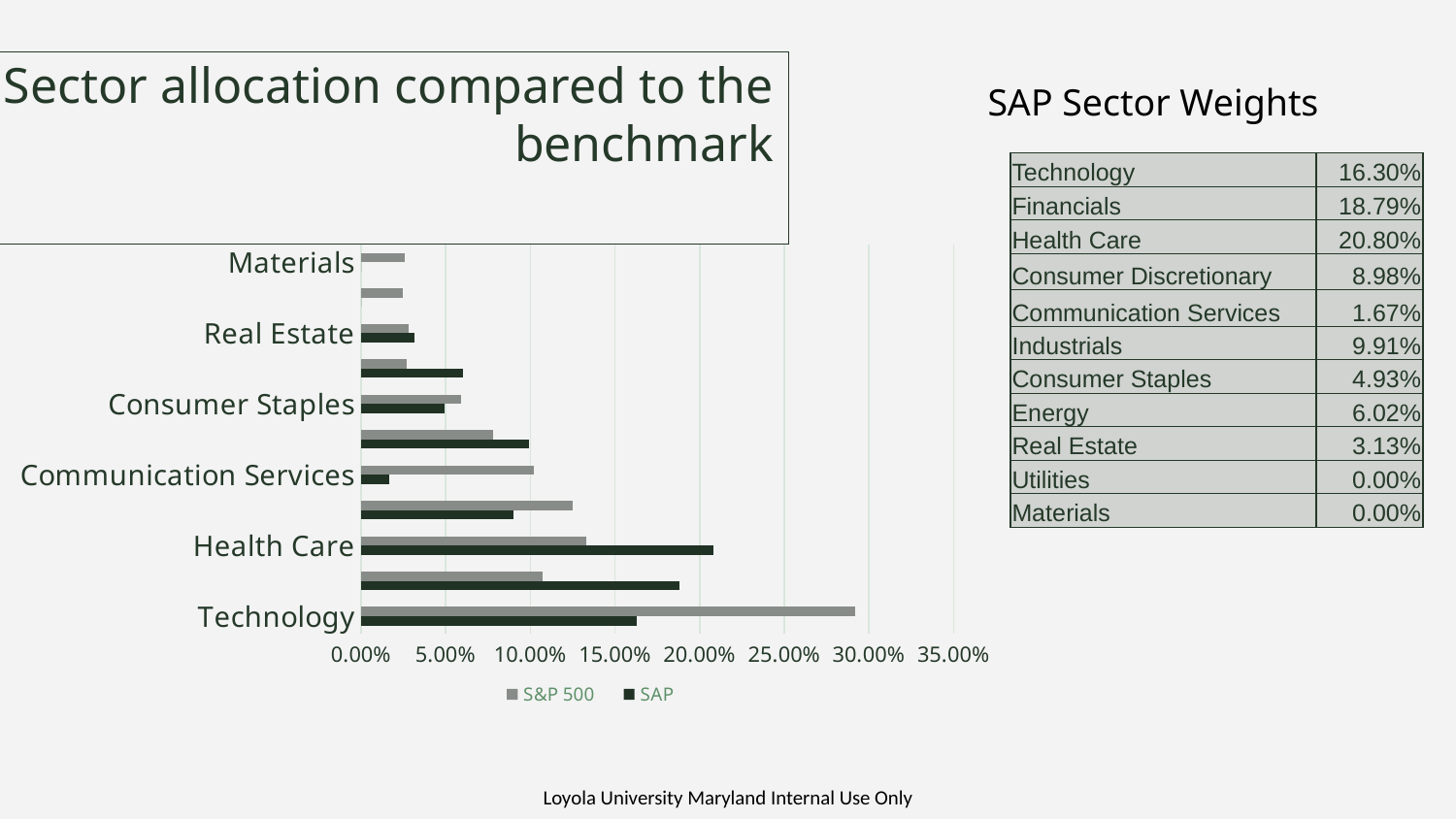
What is the highest value shown on the chart's horizontal axis? 35.00% What kind of chart is shown on the slide? bar chart Is the SAP value for Communication Services greater or less than 5.00%? less Which category has the highest S&P 500 value in the chart? Technology Is the S&P 500 value for Materials greater or less than 5.00%? less How many series does the chart legend list? 2 For Health Care, which is larger: the S&P 500 value or the SAP value? SAP Which labeled category has the highest SAP value in the chart? Health Care For Communication Services, which is larger: the S&P 500 value or the SAP value? S&P 500 What are the two series named in the chart legend? S&P 500 and SAP For Technology, which is larger: the S&P 500 value or the SAP value? S&P 500 Is the S&P 500 value for Technology greater or less than 25.00%? greater